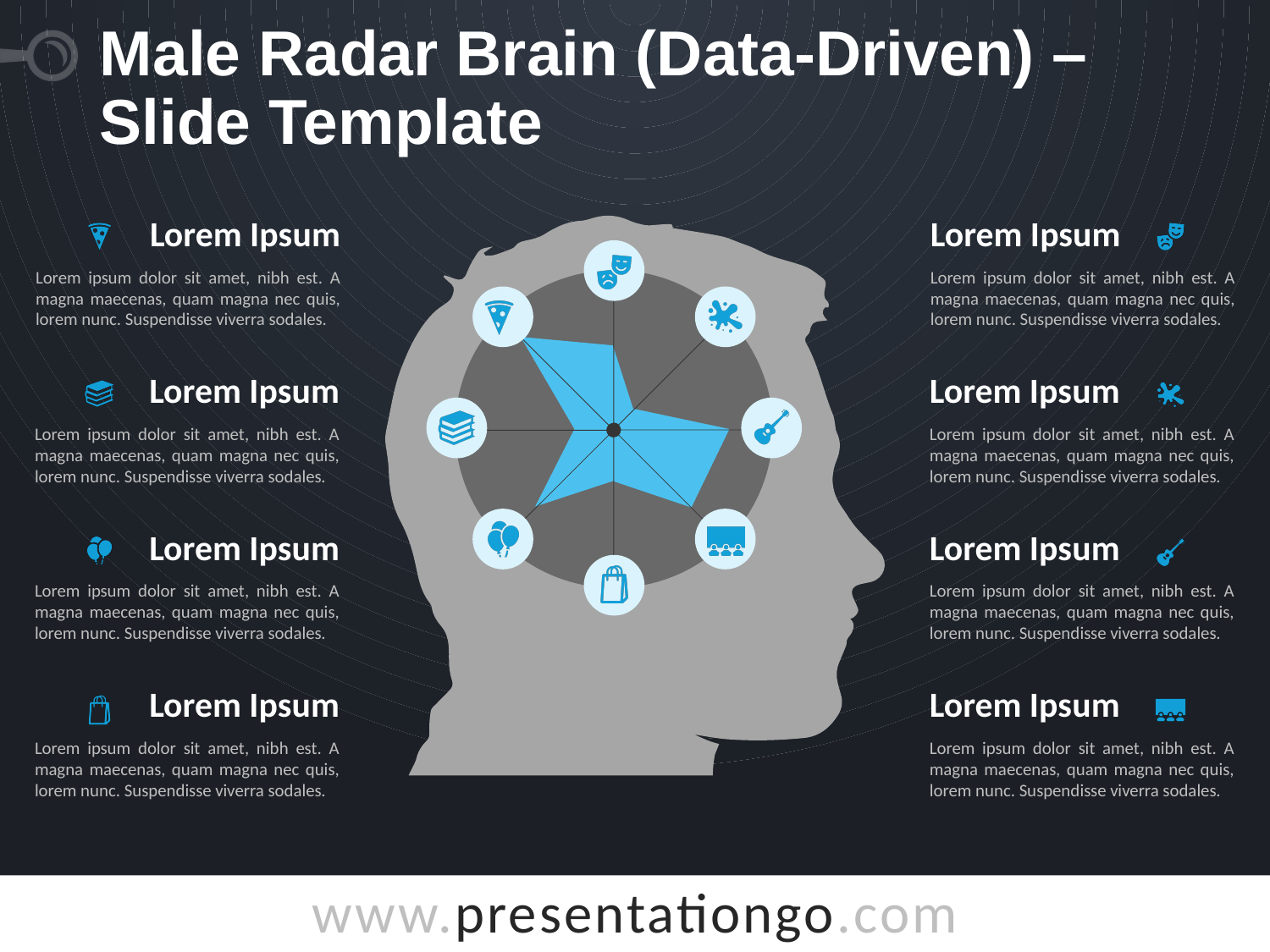
What is the title of the slide containing the radar chart? Male Radar Brain (Data-Driven) – Slide Template On the radar chart, which is larger: the value on the guitar axis or the value on the books axis? guitar On the radar chart, which is larger: the value on the audience/theater-seats axis or the value on the shopping-bag axis? audience/theater-seats What colour is the filled data area of the radar chart? blue How many data series are plotted on the radar chart? 1 What kind of chart is shown inside the head silhouette? radar chart On the radar chart, which is larger: the value on the pizza axis or the value on the paint-splash axis? pizza How many axes (categories) does the radar chart have? 8